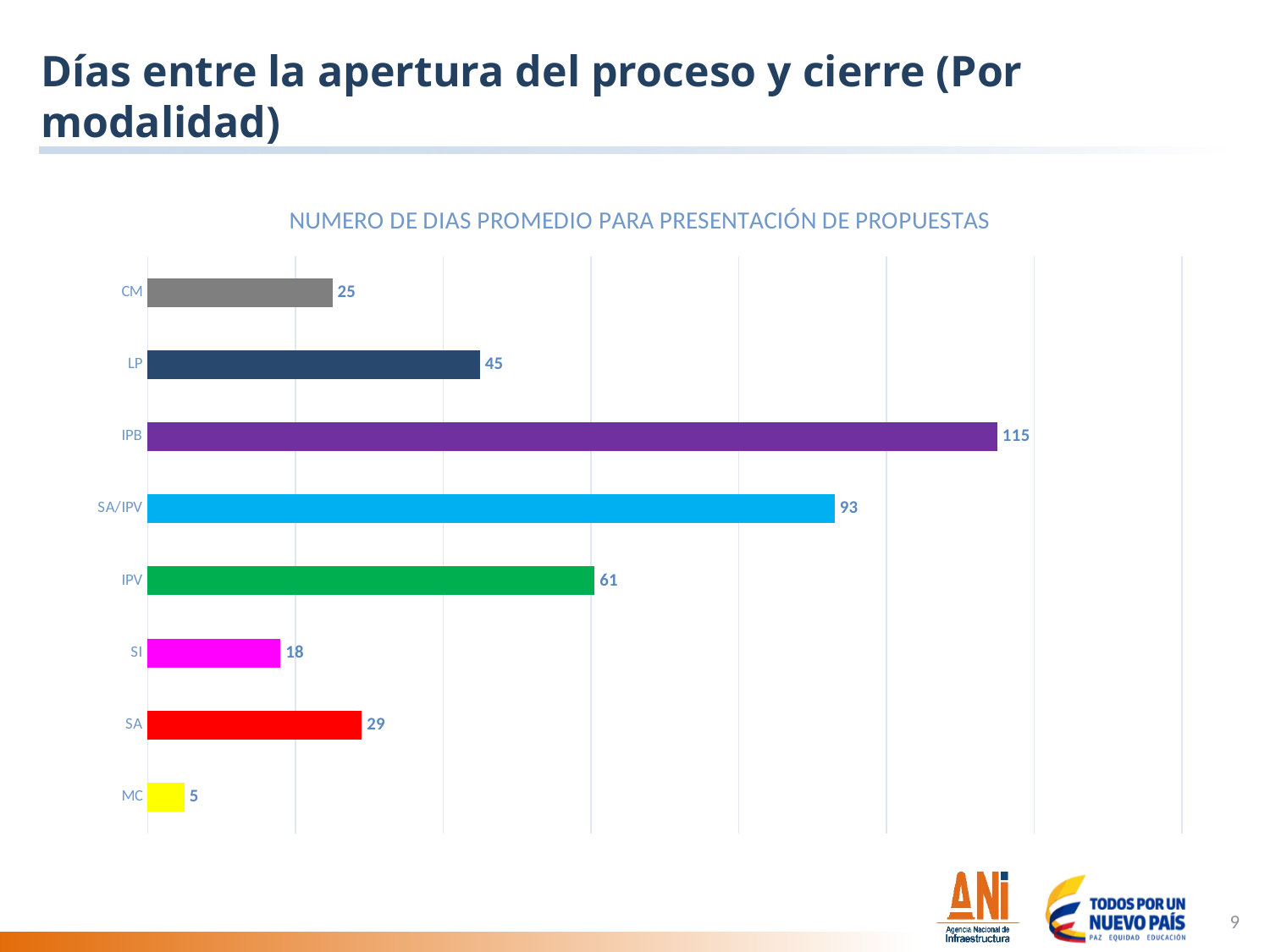
Which is larger, the value for SA or the value for SI? SA What is the difference between the values for IPB and SA/IPV? 22 Which category has the lowest value? MC What kind of chart is shown on the slide? Bar chart What is the value for MC? 5 What is the difference between the values for LP and CM? 20 Which category has the highest value? IPB Which is larger, the value for IPV or the value for LP? IPV What is the value for SA/IPV? 93 What is the title of the chart? NUMERO DE DIAS PROMEDIO PARA PRESENTACIÓN DE PROPUESTAS How many categories are shown in the chart? 8 What is the value for IPB? 115